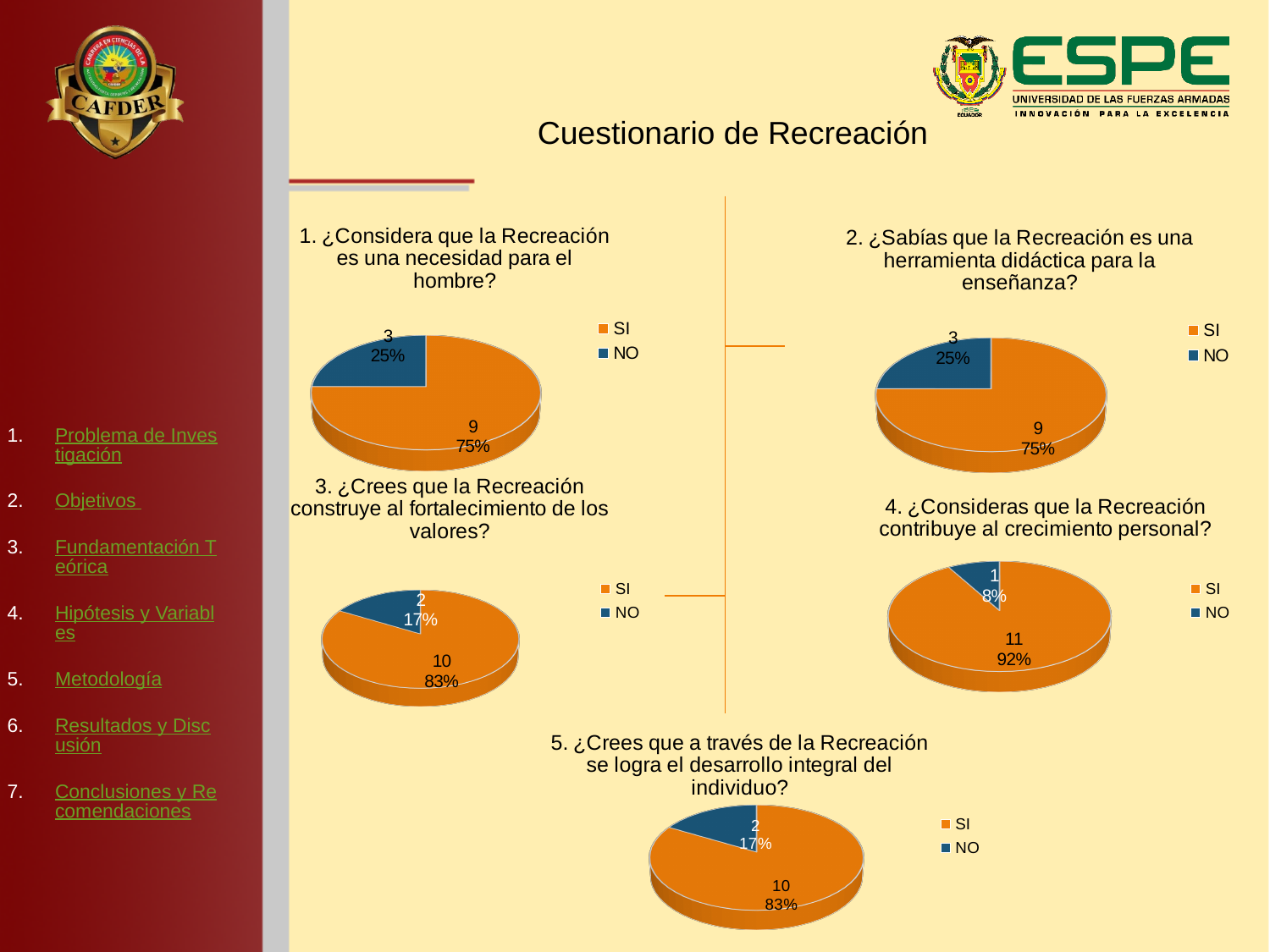
In the chart for question 5 ("¿Crees que a través de la Recreación se logra el desarrollo integral del individuo?"), what percentage of respondents answered NO? 17% In the chart for question 4 ("¿Consideras que la Recreación contribuye al crecimiento personal?"), what percentage of respondents answered SI? 92% In the chart for question 4 ("¿Consideras que la Recreación contribuye al crecimiento personal?"), how many respondents answered NO? 1 In the chart for question 2 ("¿Sabías que la Recreación es una herramienta didáctica para la enseñanza?"), what percentage of respondents answered NO? 25% In the chart for question 3 ("¿Crees que la Recreación construye al fortalecimiento de los valores?"), how many respondents answered SI? 10 In the chart for question 1 ("¿Considera que la Recreación es una necesidad para el hombre?"), what percentage of respondents answered SI? 75% How many entries does the legend list for the chart for question 2 ("¿Sabías que la Recreación es una herramienta didáctica para la enseñanza?")? 2 In the chart for question 3 ("¿Crees que la Recreación construye al fortalecimiento de los valores?"), what is the difference between the number of SI and NO responses? 8 In the chart for question 1 ("¿Considera que la Recreación es una necesidad para el hombre?"), how many respondents answered NO? 3 In the chart for question 1 ("¿Considera que la Recreación es una necesidad para el hombre?"), what colour represents the SI responses? Orange In the chart for question 4 ("¿Consideras que la Recreación contribuye al crecimiento personal?"), which response is larger, SI or NO? SI What type of chart is used for question 5 ("¿Crees que a través de la Recreación se logra el desarrollo integral del individuo?")? Pie chart